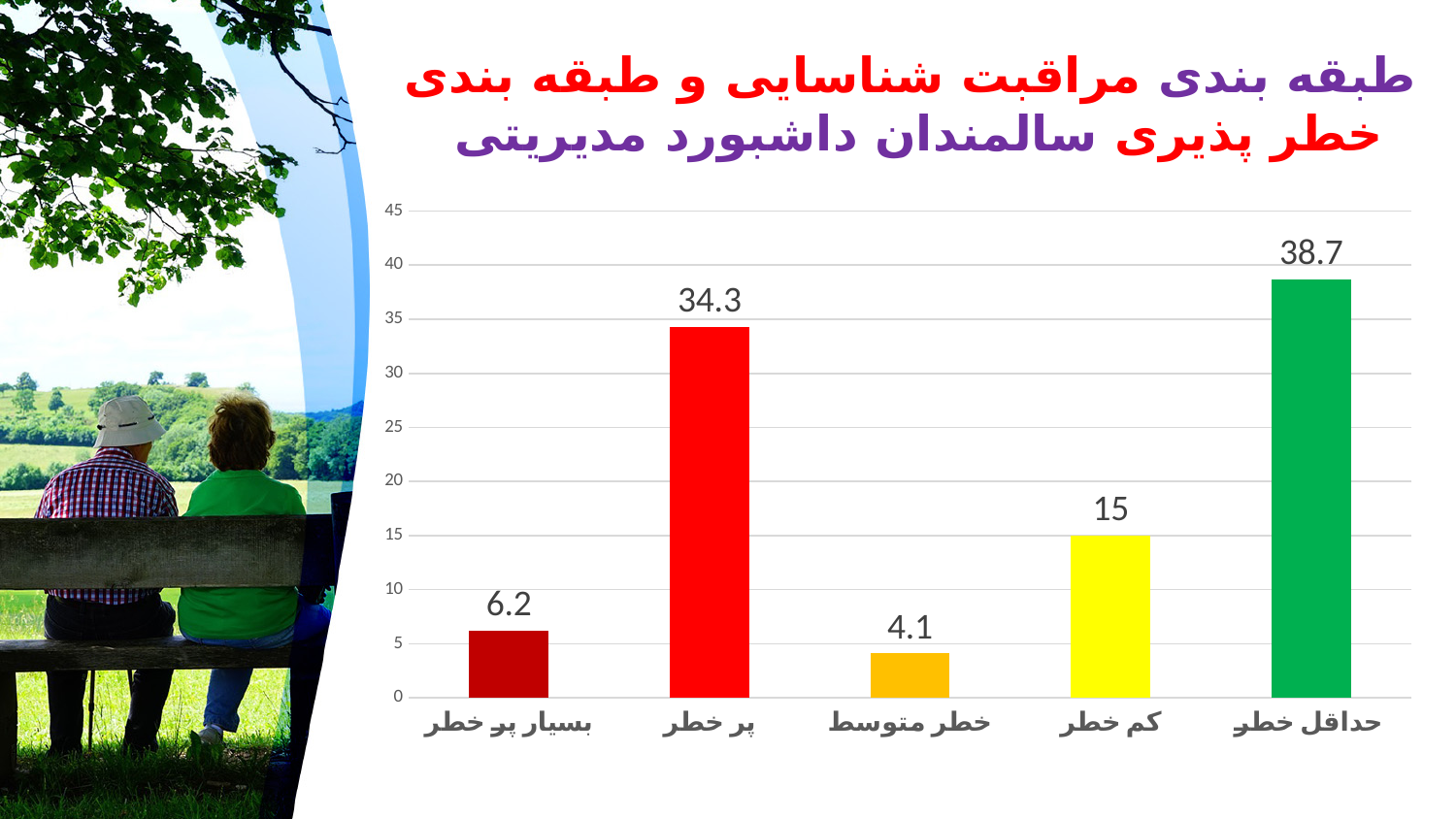
Which is larger, the value for "کم خطر" or the value for "بسیار پر خطر"? کم خطر What is the value for the category "بسیار پر خطر"? 6.2 What is the value for the category "پر خطر"? 34.3 Which category has the lowest value? خطر متوسط What is the value for the category "حداقل خطر"? 38.7 What is the value for the category "کم خطر"? 15 What kind of chart is shown on the slide? Bar chart Which category has the highest value? حداقل خطر What colour is the bar for "حداقل خطر"? Green What is the difference between the values for "حداقل خطر" and "پر خطر"? 4.4 What is the value for the category "خطر متوسط"? 4.1 How many categories are shown on the x axis? 5